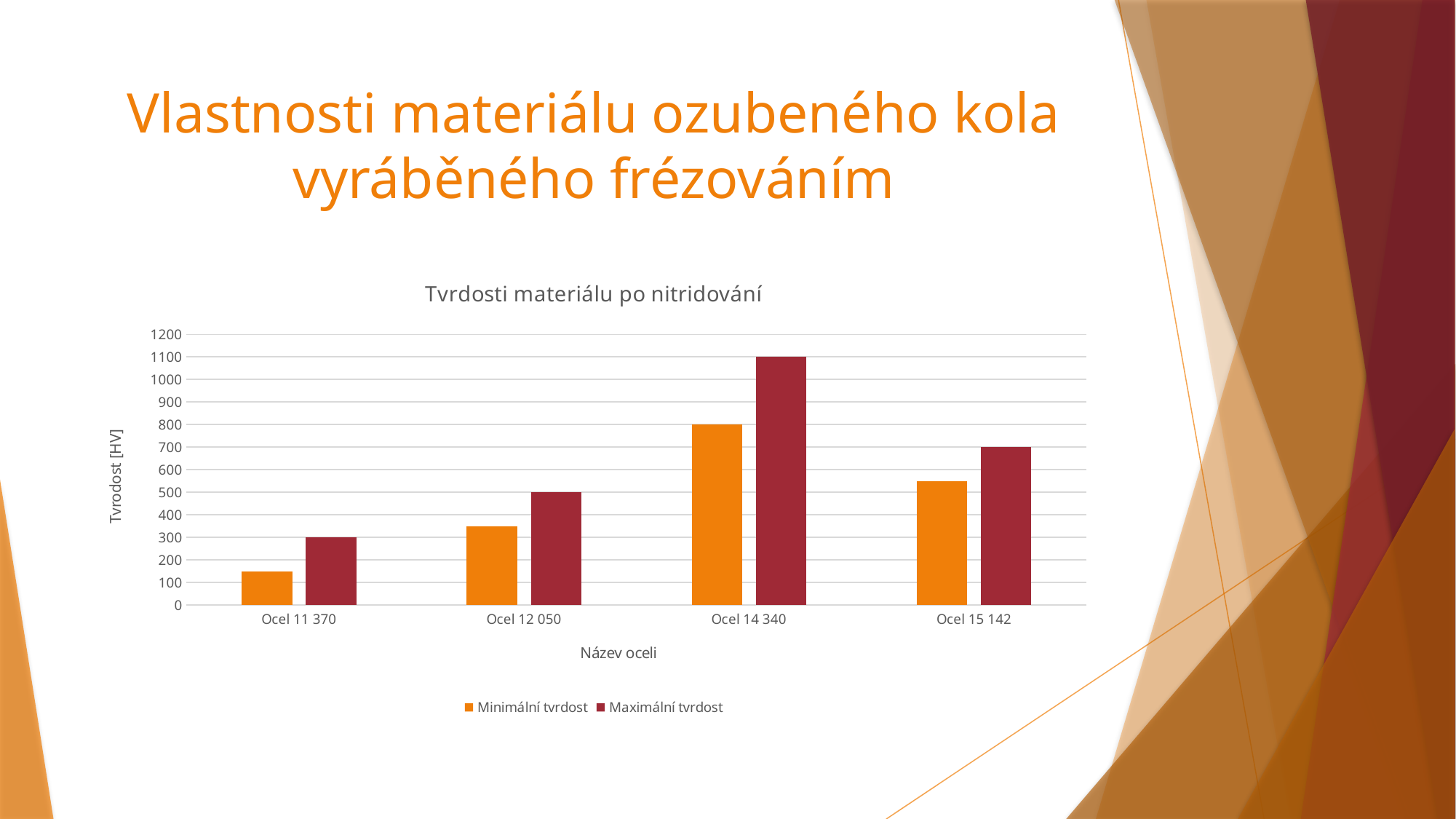
What is the Maximální tvrdost value for Ocel 15 142? 700 What is the Minimální tvrdost value for Ocel 14 340? 800 Is the Minimální tvrdost value for Ocel 12 050 greater or less than 400? less How many series does the legend list? 2 Which steel has the highest Maximální tvrdost? Ocel 14 340 What is the title of the chart? Tvrdosti materiálu po nitridování Which steel has the lowest Minimální tvrdost? Ocel 11 370 What is the Maximální tvrdost value for Ocel 14 340? 1100 How many steel categories are shown on the x axis? 4 What is the difference between the Maximální tvrdost and Minimální tvrdost for Ocel 14 340? 300 What is the Maximální tvrdost value for Ocel 12 050? 500 What type of chart is shown on the slide? bar chart